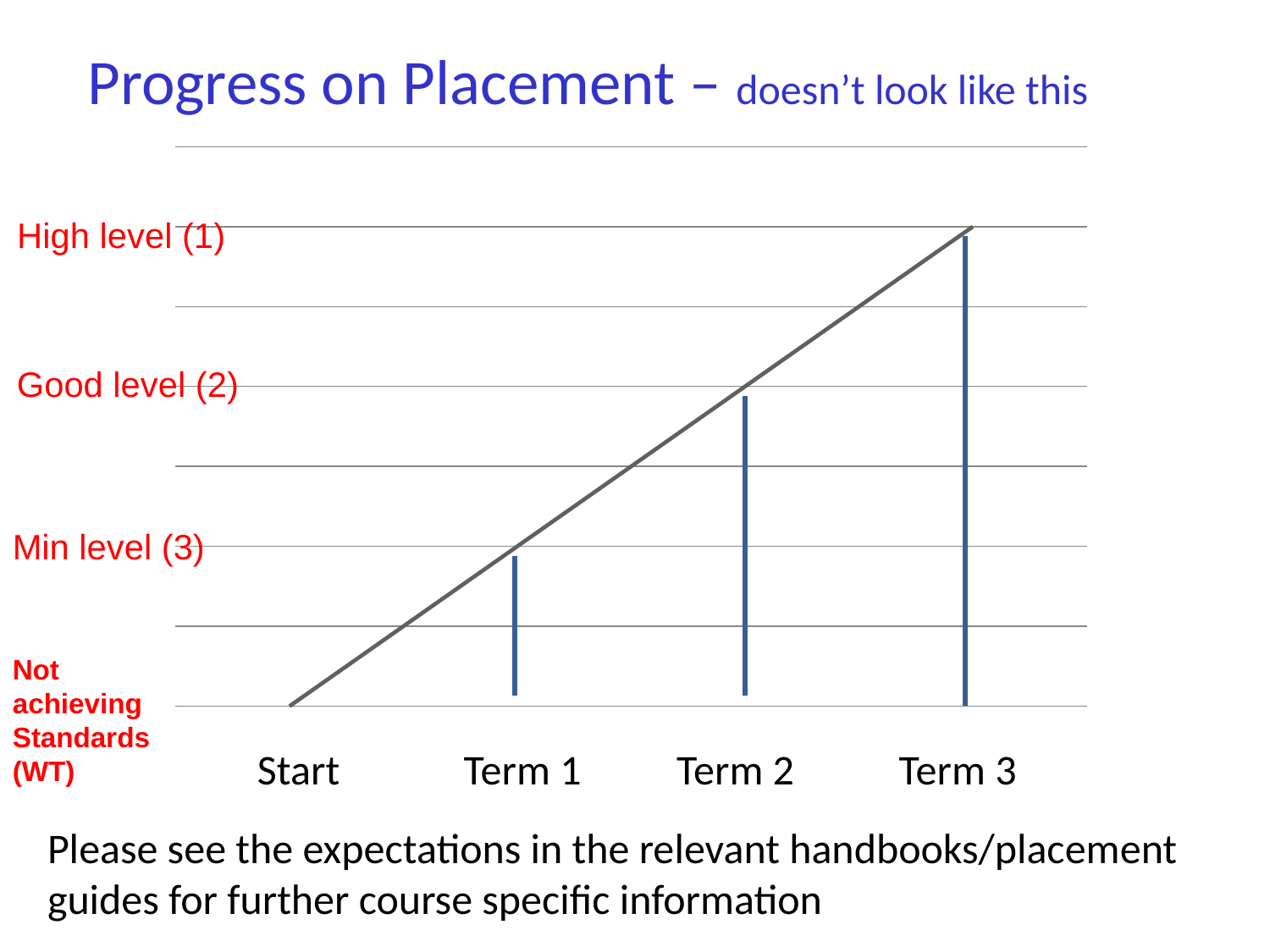
Is the bar for Term 2 taller or shorter than the bar for Term 1? taller What is the title of the chart on the slide? Progress on Placement – doesn't look like this Which term has the tallest bar in the chart? Term 3 How many categories are shown on the x axis of the chart? 4 What are the category labels along the x axis of the chart? Start, Term 1, Term 2, Term 3 Which term has the shortest bar in the chart? Term 1 Which level does the bar for Term 2 reach in the chart? Good level (2) Do the values in the chart rise or fall from Start to Term 3? rise At which x-axis category does the line in the chart start at the bottom level? Start What is the label at the bottom of the y axis of the chart? Not achieving Standards (WT) Which level does the bar for Term 3 reach in the chart? High level (1) Which level does the bar for Term 1 reach in the chart? Min level (3)